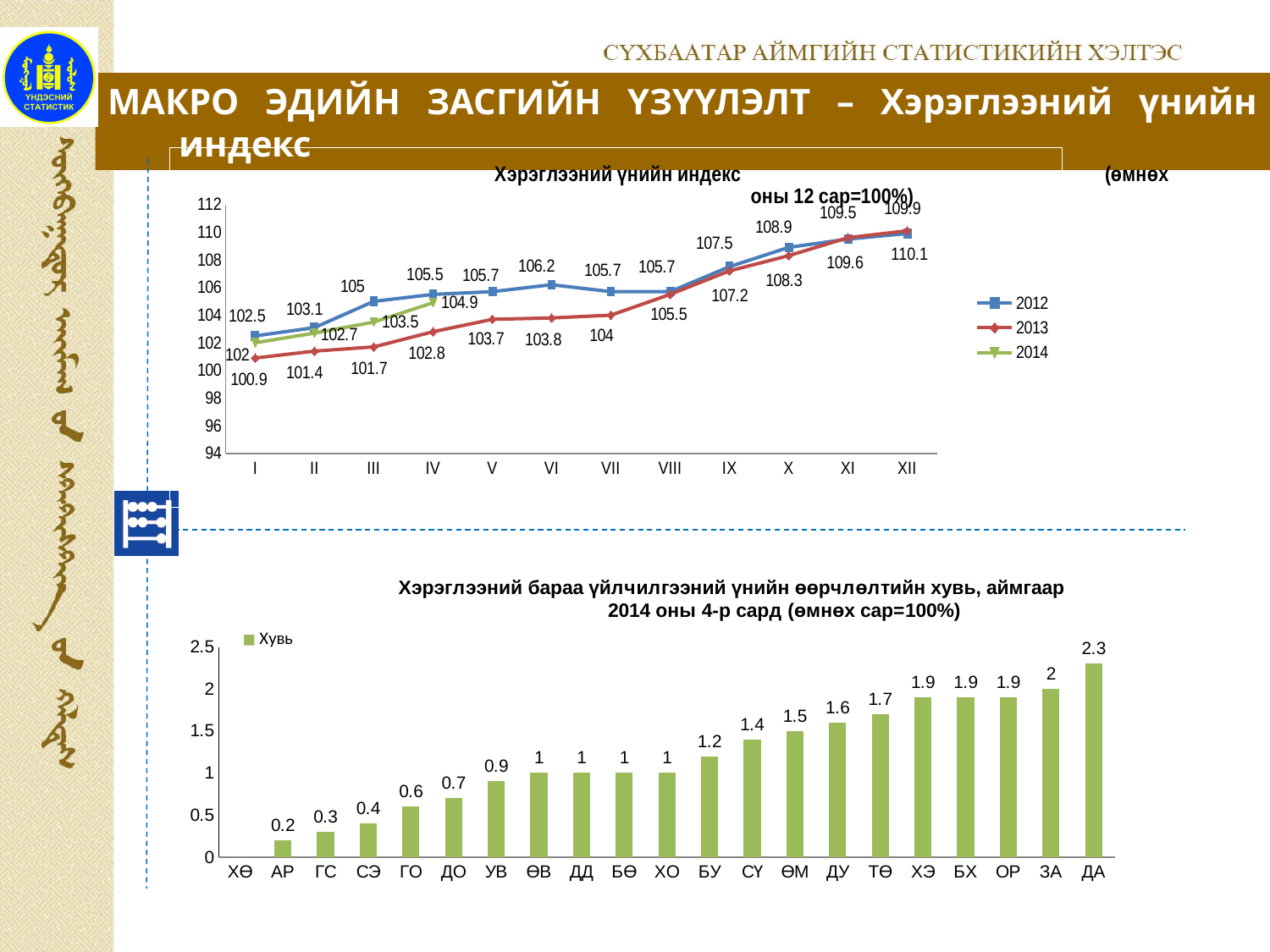
In the top chart 'Хэрэглээний үнийн индекс', what is the 2012 value for month VI? 106.2 In the top chart 'Хэрэглээний үнийн индекс', what is the 2014 value for month IV? 104.9 In the top chart 'Хэрэглээний үнийн индекс', how many series does the legend list? 3 In the top chart 'Хэрэглээний үнийн индекс', does the 2013 series rise or fall from month I to month XII? rise In the top chart 'Хэрэглээний үнийн индекс', how many data points does the 2014 series have? 4 In the bottom chart 'Хэрэглээний бараа үйлчилгээний үнийн өөрчлөлтийн хувь, аймгаар', which category has the highest value? ДА In the top chart 'Хэрэглээний үнийн индекс', which series has the larger value in month I, 2012 or 2013? 2012 In the bottom chart 'Хэрэглээний бараа үйлчилгээний үнийн өөрчлөлтийн хувь, аймгаар', what is the value for ТӨ? 1.7 In the top chart 'Хэрэглээний үнийн индекс', what is the difference between the 2013 and 2012 values for month XII? 0.2 What kind of chart is the bottom chart, 'Хэрэглээний бараа үйлчилгээний үнийн өөрчлөлтийн хувь, аймгаар'? bar chart In the top chart 'Хэрэглээний үнийн индекс', what is the 2013 value for month XII? 110.1 What kind of chart is the top chart, 'Хэрэглээний үнийн индекс'? line chart